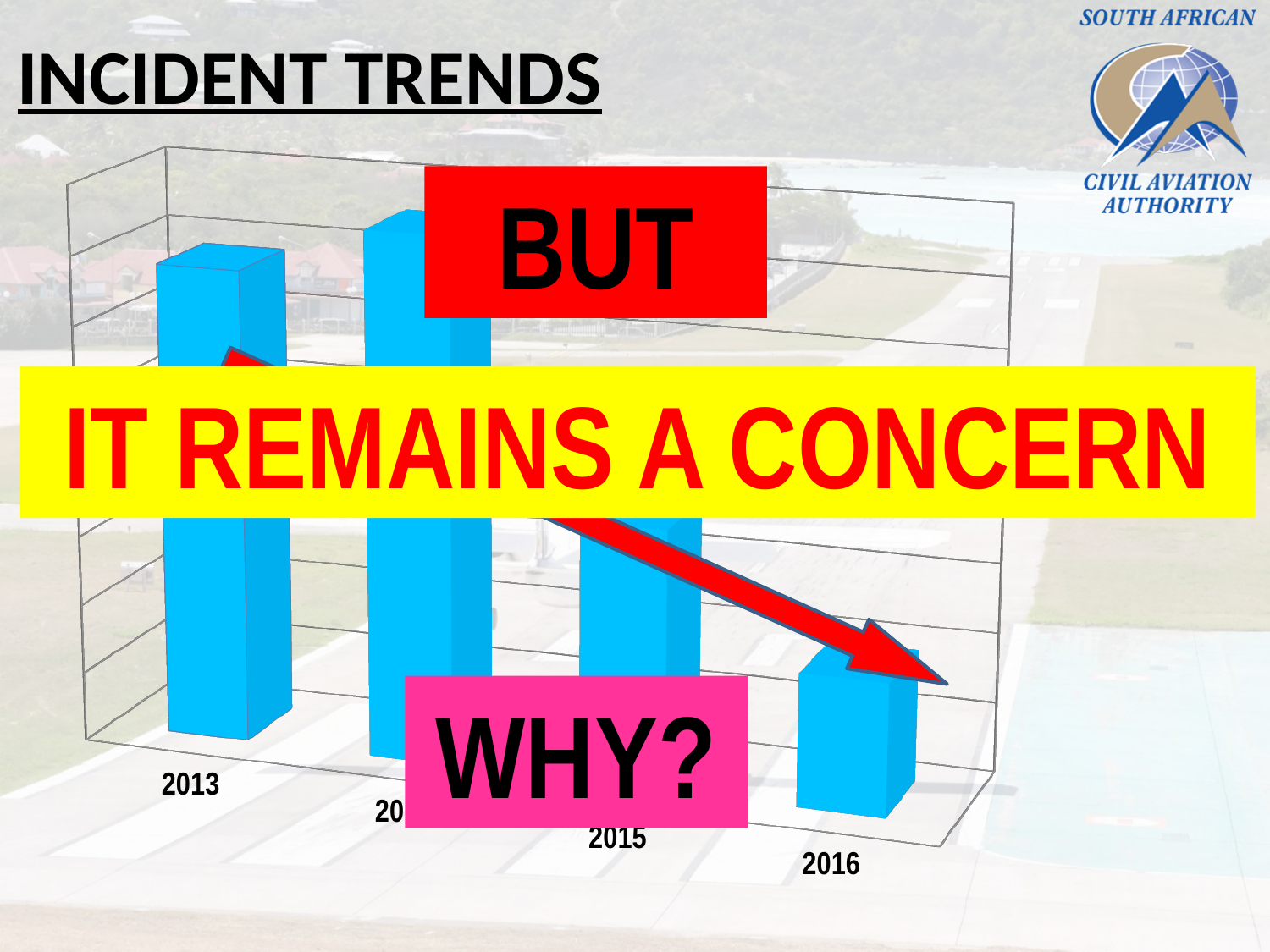
Which is larger, the bar for 2013 or the bar for 2015? 2013 Comparing the first year (2013) with the last year (2016), do the values rise or fall? fall What colour are the bars in the chart? blue Which is larger, the bar for 2015 or the bar for 2016? 2015 Which year has the lowest bar in the chart? 2016 What kind of chart is shown on the slide? bar chart Which is larger, the bar for 2013 or the bar for 2016? 2013 How many bars (years) are plotted in the chart? 4 Do the bars rise or fall from 2015 to 2016? fall What is the title of the slide containing the chart? INCIDENT TRENDS